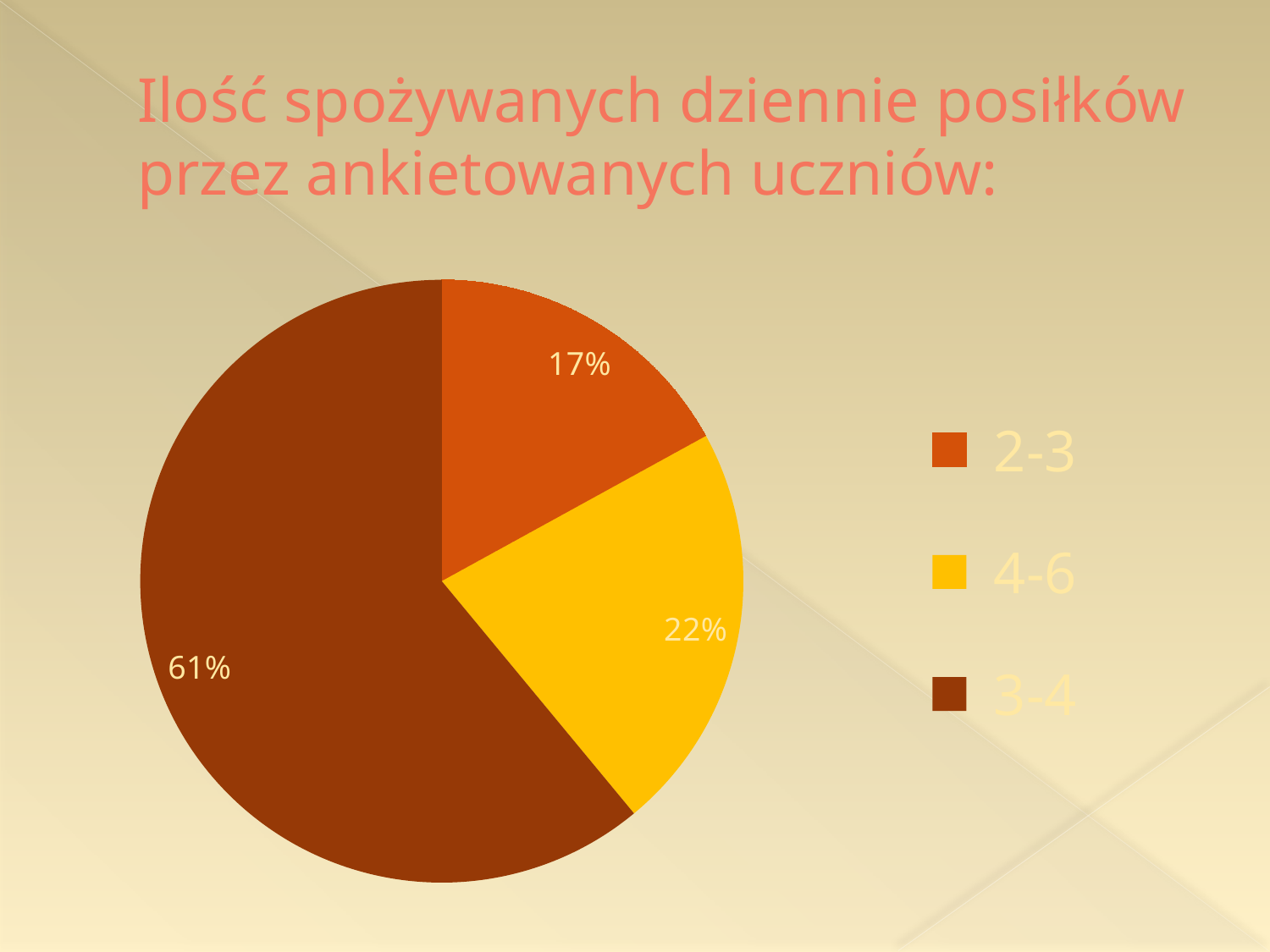
Which is larger, the 4-6 slice or the 2-3 slice? 4-6 What is the difference in percentage points between the 4-6 slice and the 2-3 slice? 5 How many categories does the pie chart show? 3 What share of the pie does the 4-6 category have? 22% What share of the pie does the 3-4 category have? 61% What share of the pie does the 2-3 category have? 17% What kind of chart is shown on the slide? pie chart What is the difference in percentage points between the 3-4 slice and the 4-6 slice? 39 Which category has the smallest slice of the pie? 2-3 What colour is the slice for the 4-6 category? yellow Which category has the largest slice of the pie? 3-4 What is the title of the chart on the slide? Ilość spożywanych dziennie posiłków przez ankietowanych uczniów: